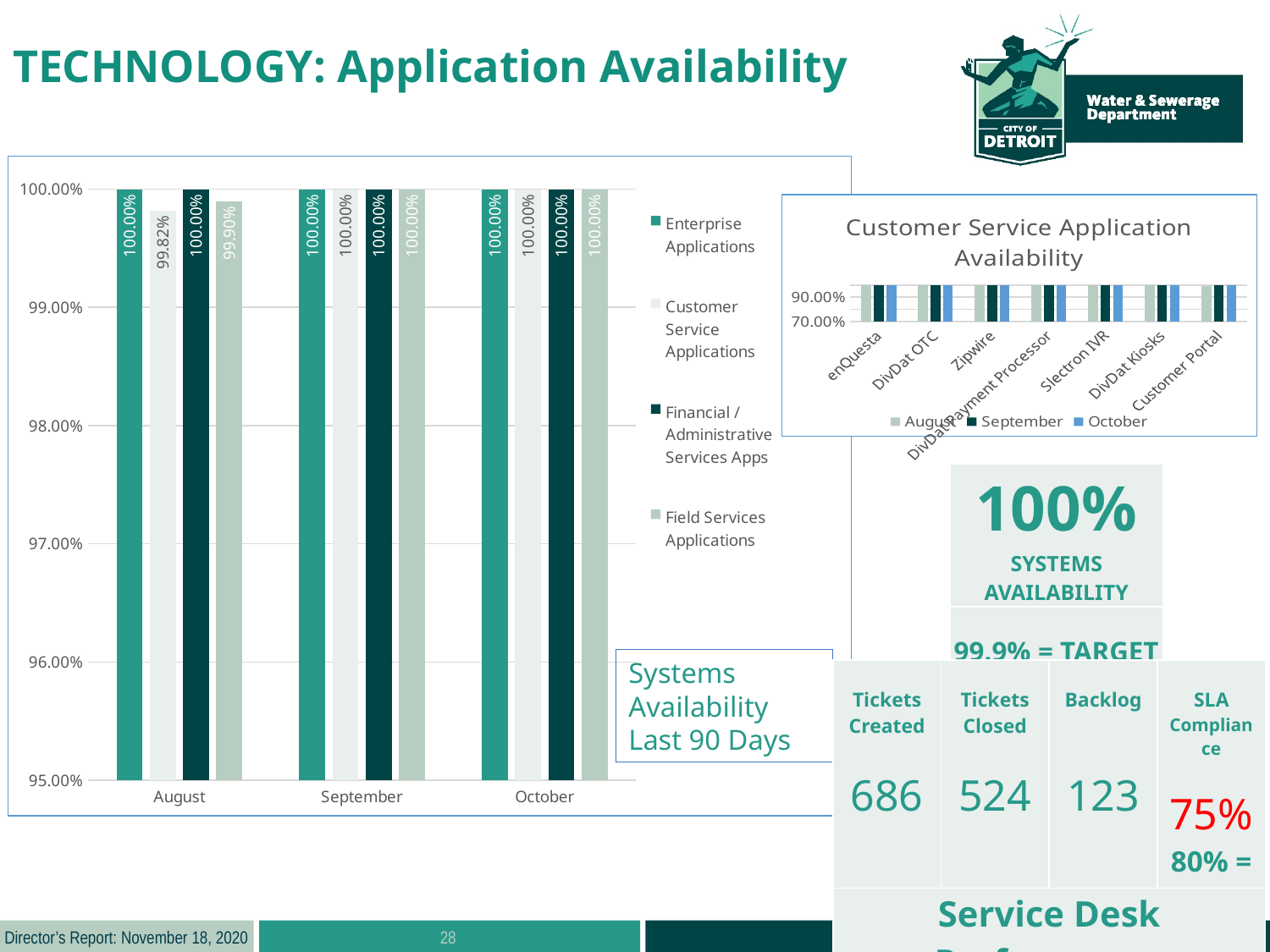
In the Systems Availability Last 90 Days chart, how many series does the legend list? 4 In the Systems Availability Last 90 Days chart, which series has the lowest value in August? Customer Service Applications In the Customer Service Application Availability chart, how many applications are shown on the x axis? 7 In the Systems Availability Last 90 Days chart, what is the difference between the Enterprise Applications and Customer Service Applications values in August? 0.18% What kind of chart is the Systems Availability Last 90 Days chart? Bar chart In the Customer Service Application Availability chart, how many series does the legend list? 3 In the Systems Availability Last 90 Days chart, what is the value for Enterprise Applications in September? 100.00% In the Systems Availability Last 90 Days chart, how many months are shown on the x axis? 3 In the Systems Availability Last 90 Days chart, what is the value for Field Services Applications in August? 99.90% In the Systems Availability Last 90 Days chart, what is the value for Customer Service Applications in August? 99.82% In the Customer Service Application Availability chart, is the value for enQuesta in October greater or less than 90.00%? greater In the Systems Availability Last 90 Days chart, which is larger in August: Customer Service Applications or Field Services Applications? Field Services Applications